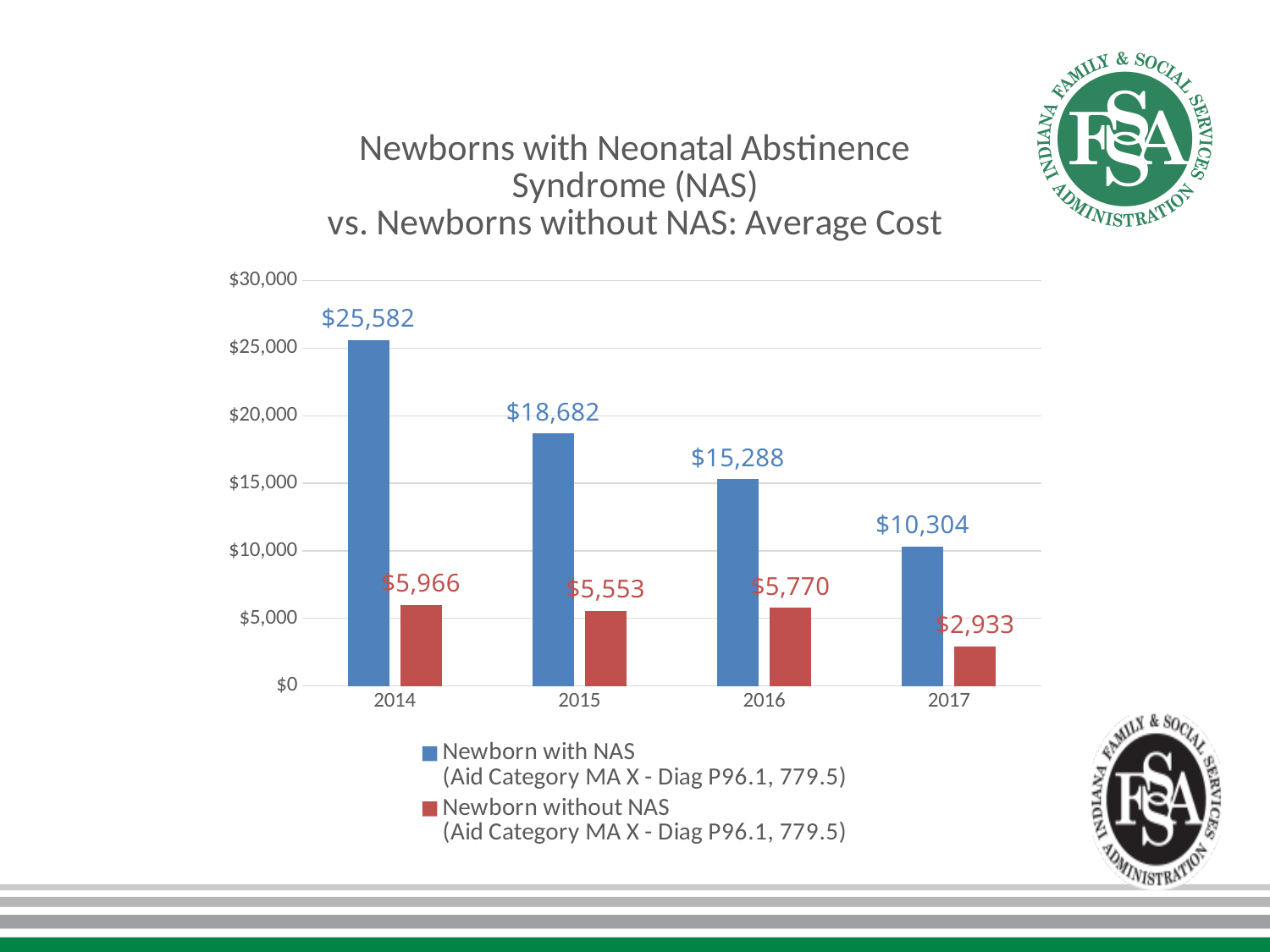
What is the average cost for a newborn with NAS in 2016? $15,288 What is the average cost for a newborn with NAS in 2014? $25,582 Does the average cost for a newborn with NAS rise or fall from 2014 to 2017? Fall Is the average cost for a newborn with NAS in 2017 greater or less than $10,000? greater How many years are shown on the x axis? 4 What is the difference between the average cost for a newborn with NAS and without NAS in 2015? $13,129 Which is larger: the average cost for a newborn without NAS in 2014 or in 2016? 2014 What kind of chart is shown on the slide? Bar chart What is the average cost for a newborn without NAS in 2017? $2,933 In which year is the average cost for a newborn without NAS lowest? 2017 In which year is the average cost for a newborn with NAS highest? 2014 How many series does the legend list? 2